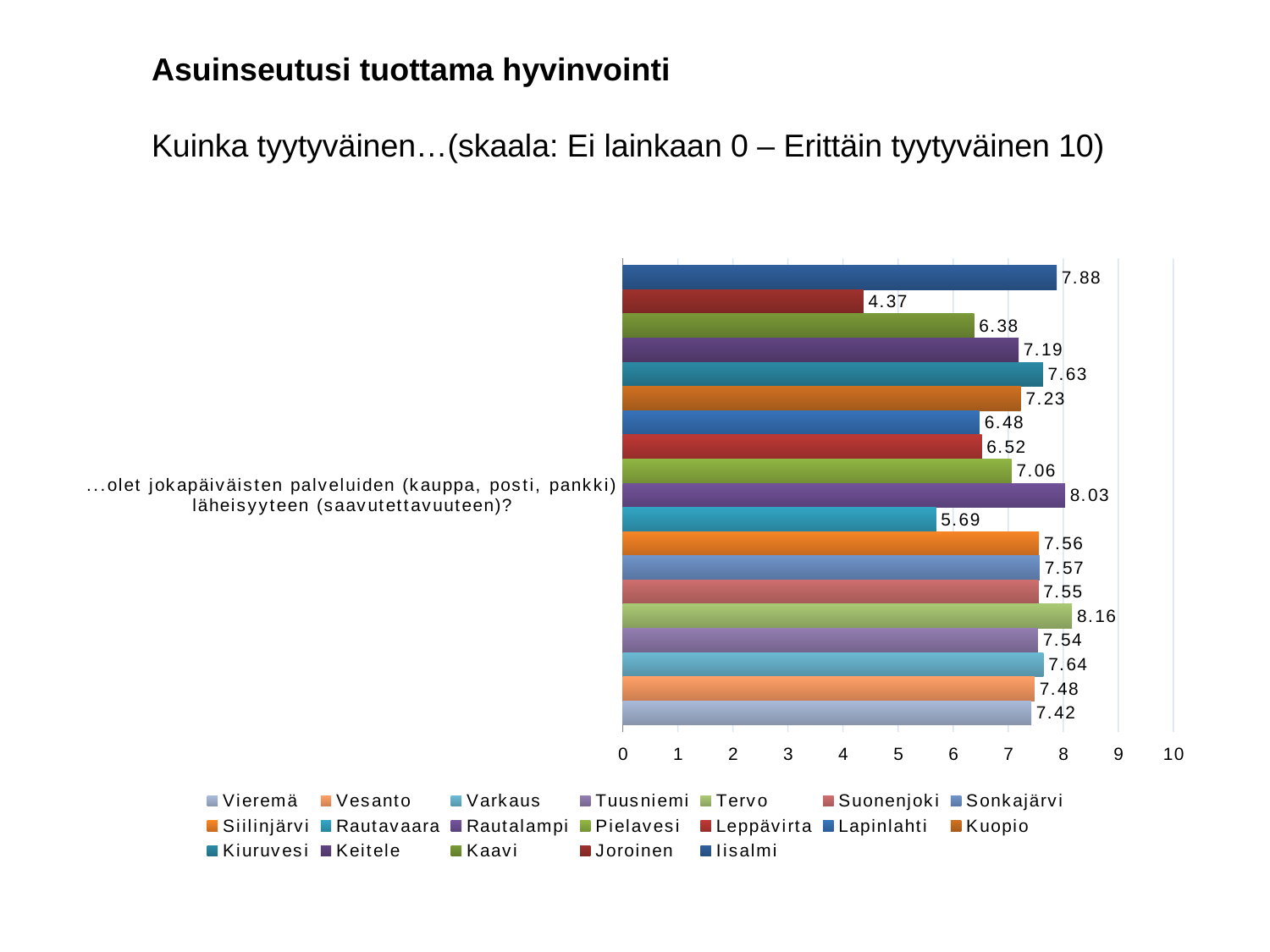
Which is larger, the value for Rautalampi or the value for Kuopio? Rautalampi What is the value for Rautavaara? 5.69 What is the difference between the values for Tervo and Joroinen? 3.79 Which municipality has the highest value? Tervo How many series does the legend list? 19 Which municipality has the lowest value? Joroinen What is the value for Joroinen? 4.37 What is the value for Tervo? 8.16 What kind of chart is shown on the slide? bar chart What is the value for Iisalmi? 7.88 Is the value for Kaavi greater or less than 7? less What is the maximum value shown on the x axis? 10